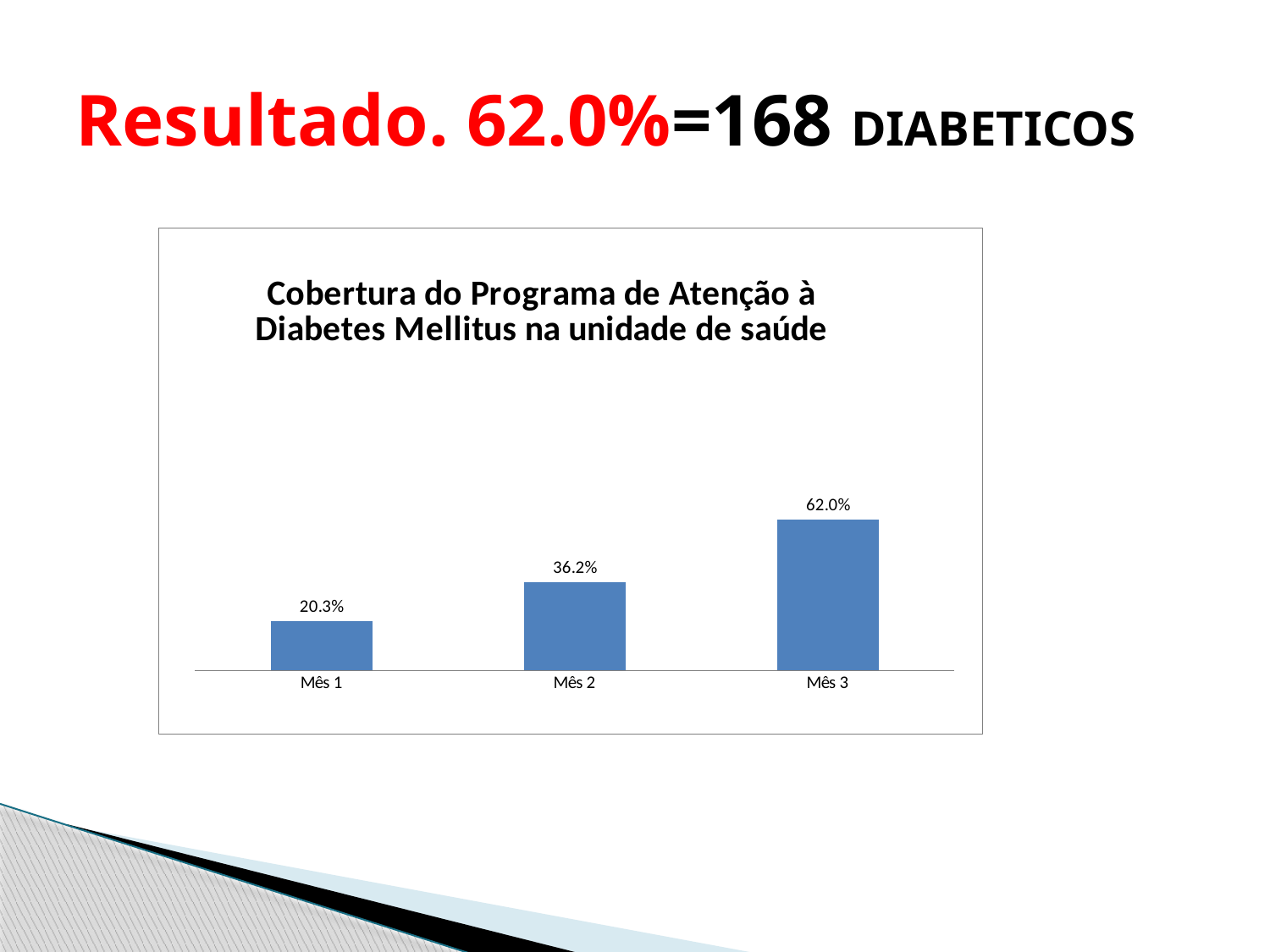
What is the value for Mês 1? 20.3% What is the value for Mês 2? 36.2% What is the difference between the values for Mês 2 and Mês 1? 15.9% Do the values rise or fall from Mês 1 to Mês 3? Rise Which month has the highest value? Mês 3 What is the value for Mês 3? 62.0% Which is larger, the value for Mês 2 or the value for Mês 3? Mês 3 Which month has the lowest value? Mês 1 How many categories are shown on the x axis? 3 What is the difference between the values for Mês 3 and Mês 1? 41.7% What kind of chart is shown on the slide? Bar chart What is the title of the chart? Cobertura do Programa de Atenção à Diabetes Mellitus na unidade de saúde